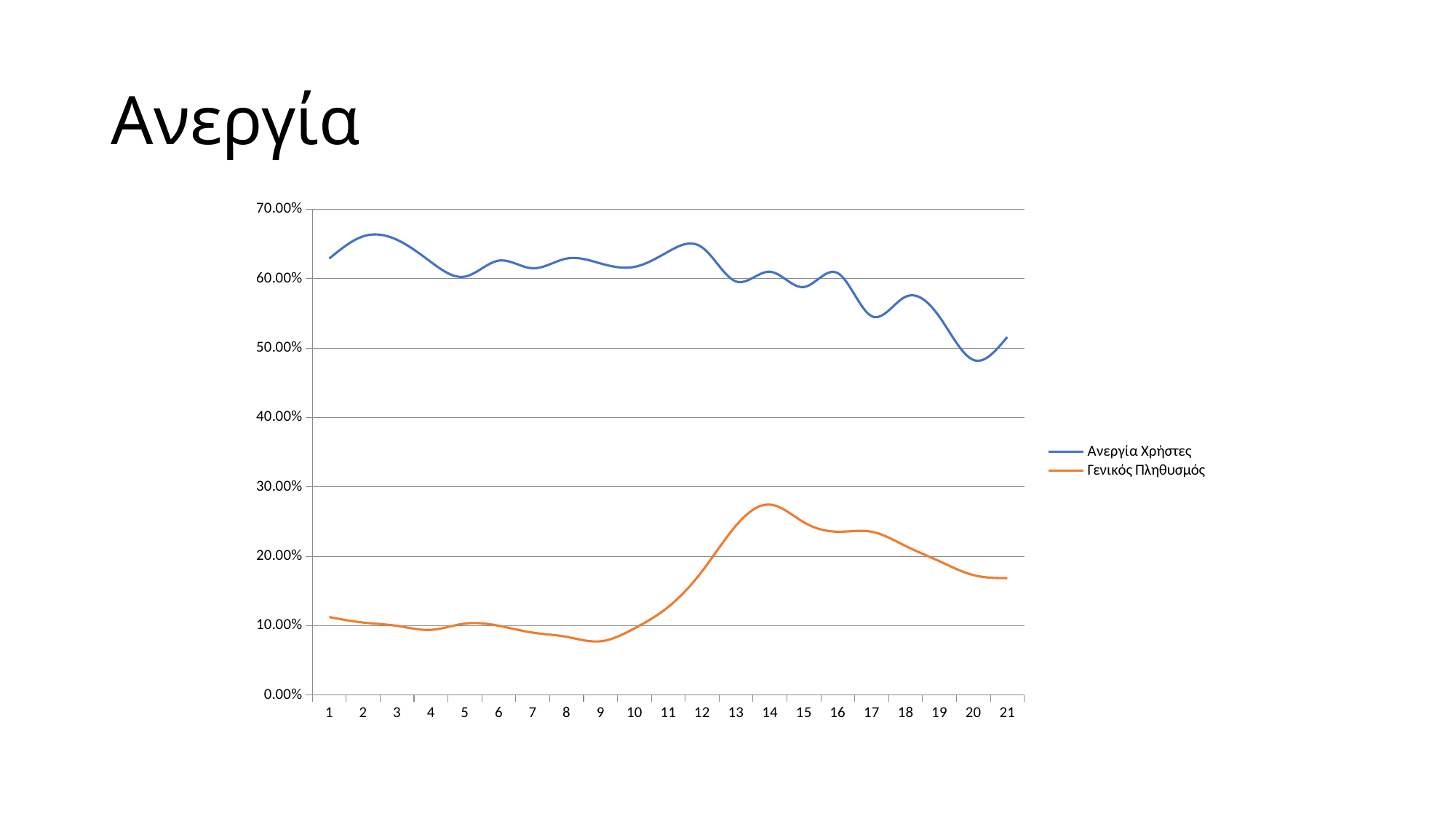
Is the value for Γενικός Πληθυσμός at point 14 greater or less than 20.00%? greater Which series is drawn in orange? Γενικός Πληθυσμός How many series does the legend list? 2 At point 12, which series has the larger value, Ανεργία Χρήστες or Γενικός Πληθυσμός? Ανεργία Χρήστες How many points are plotted along the x axis for each series? 21 Is the value for Ανεργία Χρήστες at point 20 greater or less than 50.00%? less At which x-axis point is the value for Γενικός Πληθυσμός lowest? 9 What kind of chart is shown on the slide? line chart What is the title of the slide? Ανεργία At which x-axis point is the value for Γενικός Πληθυσμός highest? 14 Does the value for Ανεργία Χρήστες overall rise or fall from point 1 to point 21? fall At which x-axis point is the value for Ανεργία Χρήστες lowest? 20